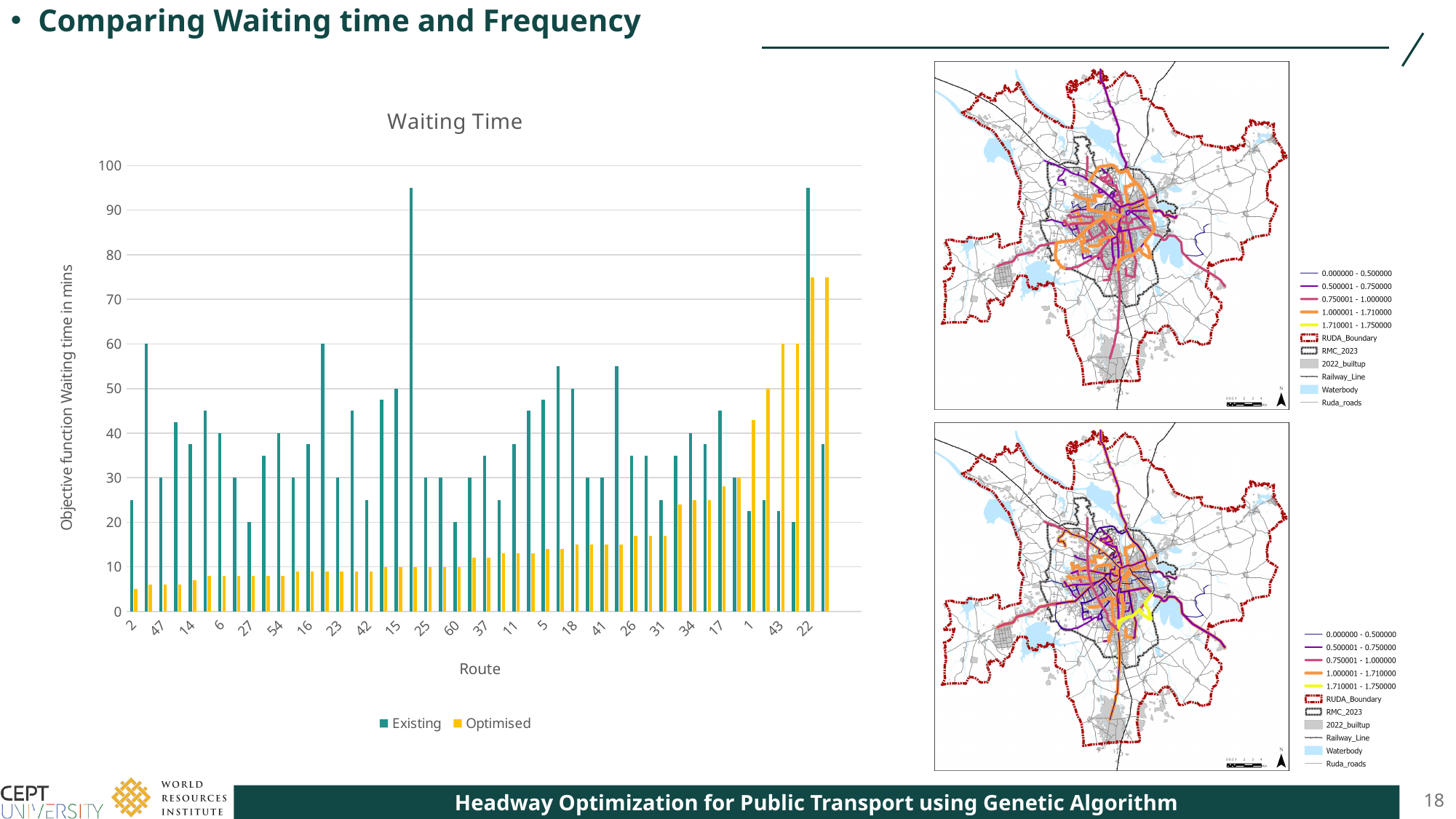
In the Waiting Time chart, is the Existing value for route 22 greater or less than 90? greater Which series in the Waiting Time chart is shown in yellow? Optimised In the Waiting Time chart, is the Optimised value for route 2 greater or less than 10? less In the Waiting Time chart, is the Optimised value for route 43 greater or less than 40? greater In the Waiting Time chart, do the Optimised values generally rise or fall from left to right along the x axis? rise In the Waiting Time chart, which is larger for route 22: the Existing value or the Optimised value? Existing What is the y-axis label of the Waiting Time chart? Objective function Waiting time in mins How many series does the legend of the Waiting Time chart list? 2 In the Waiting Time chart, which is larger for route 43: the Existing value or the Optimised value? Optimised What kind of chart is the Waiting Time chart? bar chart